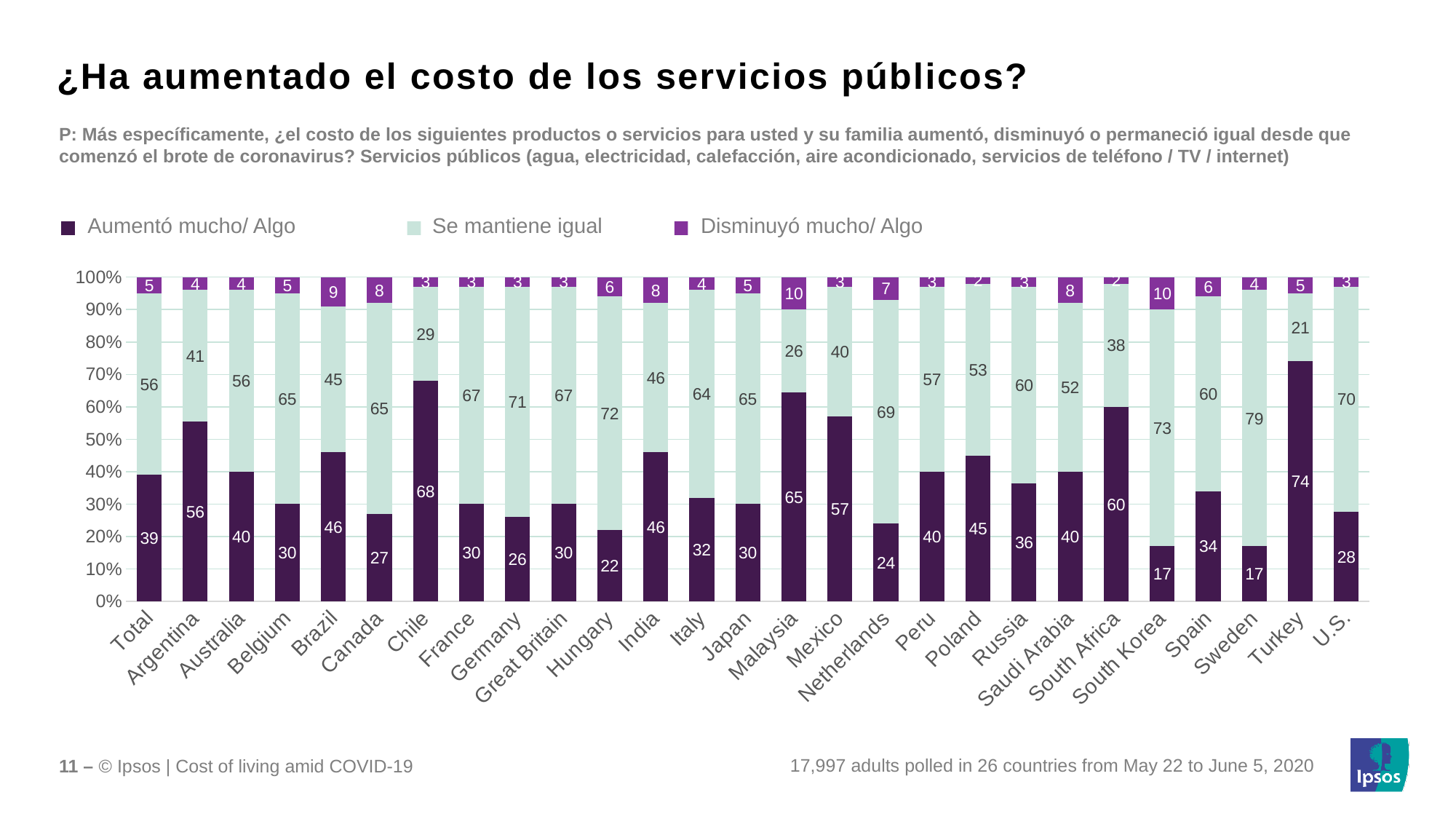
Which country has the lowest value for 'Se mantiene igual'? Turkey Which country has the highest value for 'Aumentó mucho/ Algo'? Turkey What is the value of 'Aumentó mucho/ Algo' for Turkey? 74 What is the total of the three segments for the Brazil bar? 100 What is the value of 'Disminuyó mucho/ Algo' for Malaysia? 10 How many categories are shown along the x axis? 27 How many series does the legend list? 3 Which has a larger 'Aumentó mucho/ Algo' value, Mexico or Poland? Mexico What colour represents 'Se mantiene igual' in the legend? Light teal What is the difference between the 'Aumentó mucho/ Algo' values for Chile and Canada? 41 What is the value of 'Se mantiene igual' for Sweden? 79 What type of chart is shown on the slide? Stacked bar chart